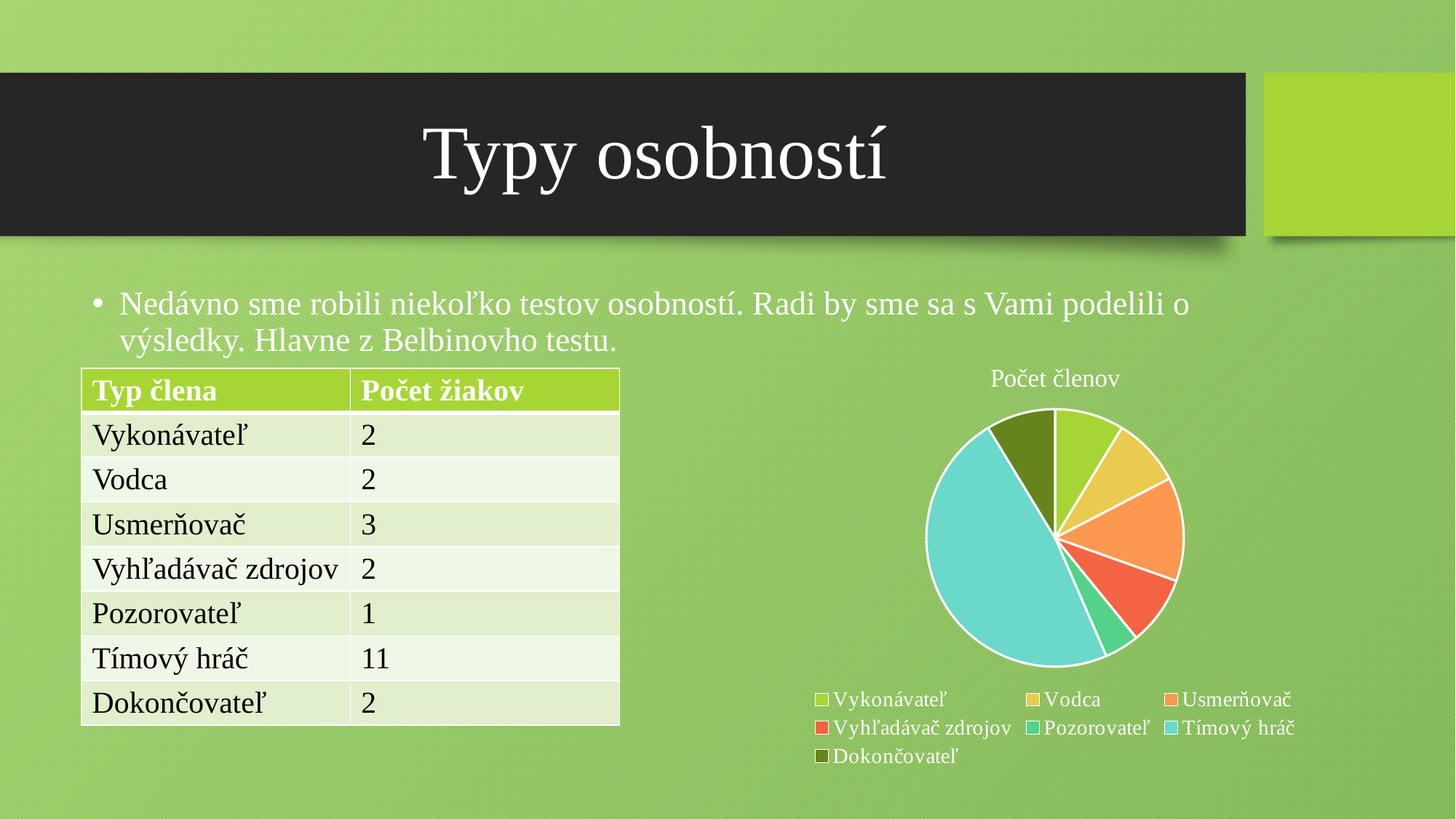
What is the difference between the values for Tímový hráč and Usmerňovač? 8 Which slice is larger in the pie chart, Usmerňovač or Vodca? Usmerňovač What kind of chart is shown on the slide? pie chart What is the title of the pie chart? Počet členov Which category has the largest slice in the pie chart? Tímový hráč Which slice is larger in the pie chart, Tímový hráč or Dokončovateľ? Tímový hráč How many entries does the pie chart's legend list? 7 What colour is the Tímový hráč slice in the pie chart? light blue (turquoise) What is the value for Tímový hráč shown on the slide? 11 What is the value for Usmerňovač shown on the slide? 3 Which category has the smallest slice in the pie chart? Pozorovateľ How many slices does the pie chart have? 7